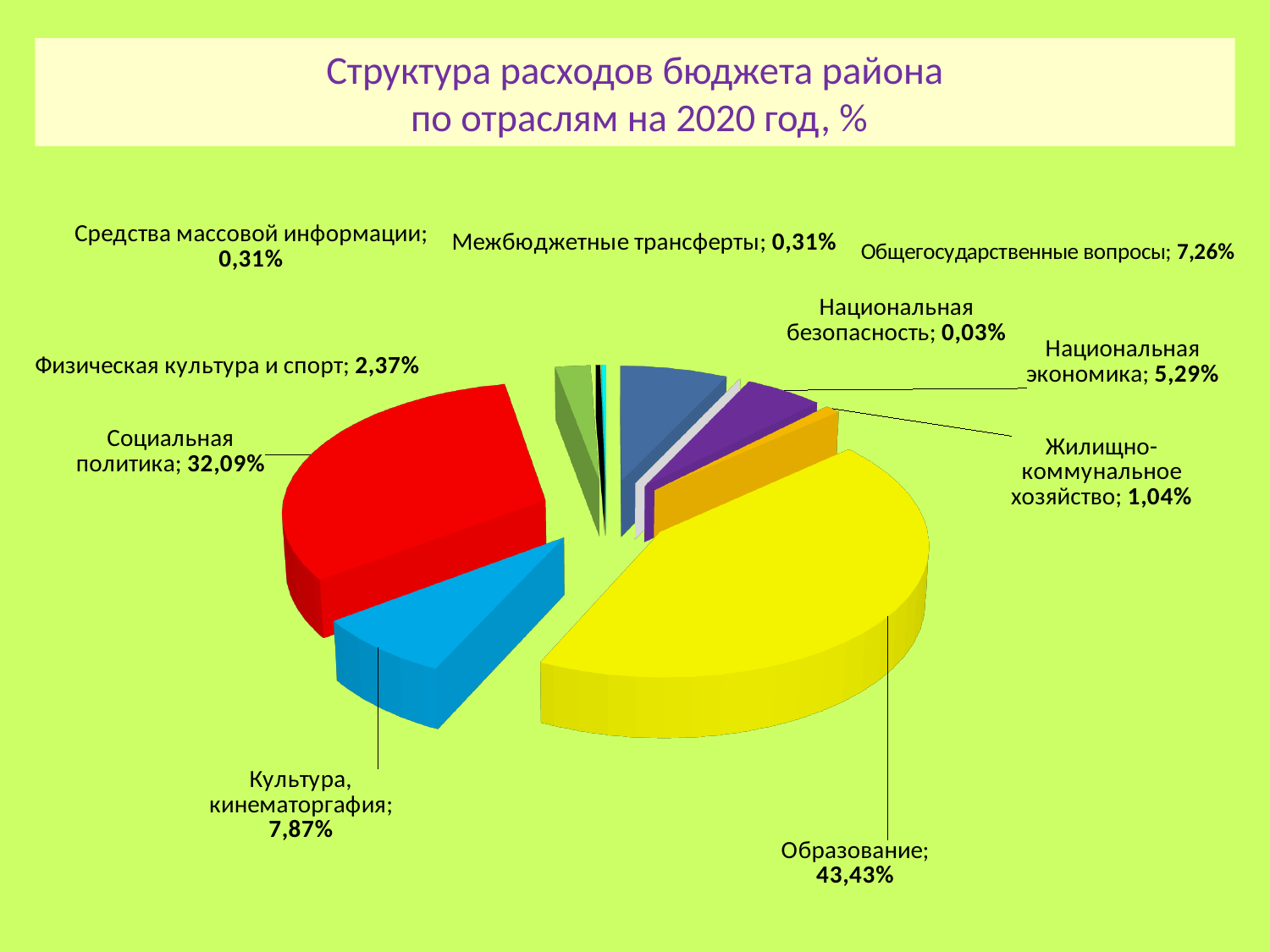
What kind of chart is shown on the slide? pie chart What is the share for Социальная политика? 32,09% What is the share for Национальная экономика? 5,29% What is the title of the chart? Структура расходов бюджета района по отраслям на 2020 год, % What is the share for Жилищно-коммунальное хозяйство? 1,04% Which has a larger share, Общегосударственные вопросы or Культура, кинематоргафия? Культура, кинематоргафия Which category has the largest share of the pie? Образование What is the difference between the shares of Образование and Социальная политика? 11,34% What is the share for Культура, кинематоргафия? 7,87% What is the share for Образование? 43,43% How many categories are shown in the pie chart? 10 Which category has the smallest share of the pie? Национальная безопасность